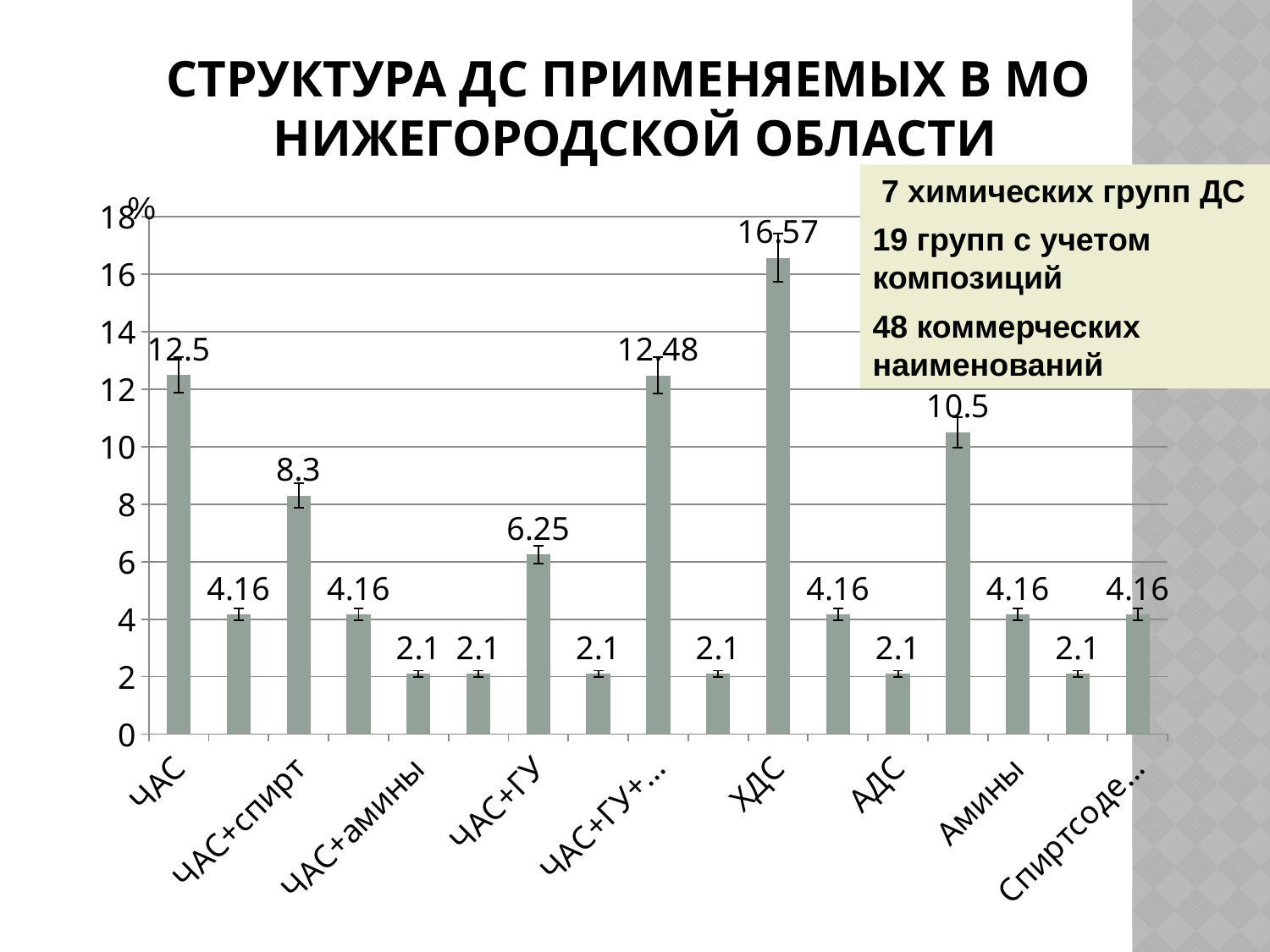
What is the difference between the values for ЧАС+спирт and ЧАС+ГУ? 2.05 Which category has the highest value? ХДС What is the value for ХДС? 16.57 How many bars are plotted in the chart? 17 What is the difference between the values for ХДС and ЧАС? 4.07 What is the value for ЧАС? 12.5 What is the value for АДС? 2.1 Which is larger, the value for ЧАС or the value for Амины? ЧАС Is the value for ХДС greater or less than 16? greater What is the value for ЧАС+ГУ? 6.25 What is the value for ЧАС+спирт? 8.3 What kind of chart is shown on the slide? bar chart